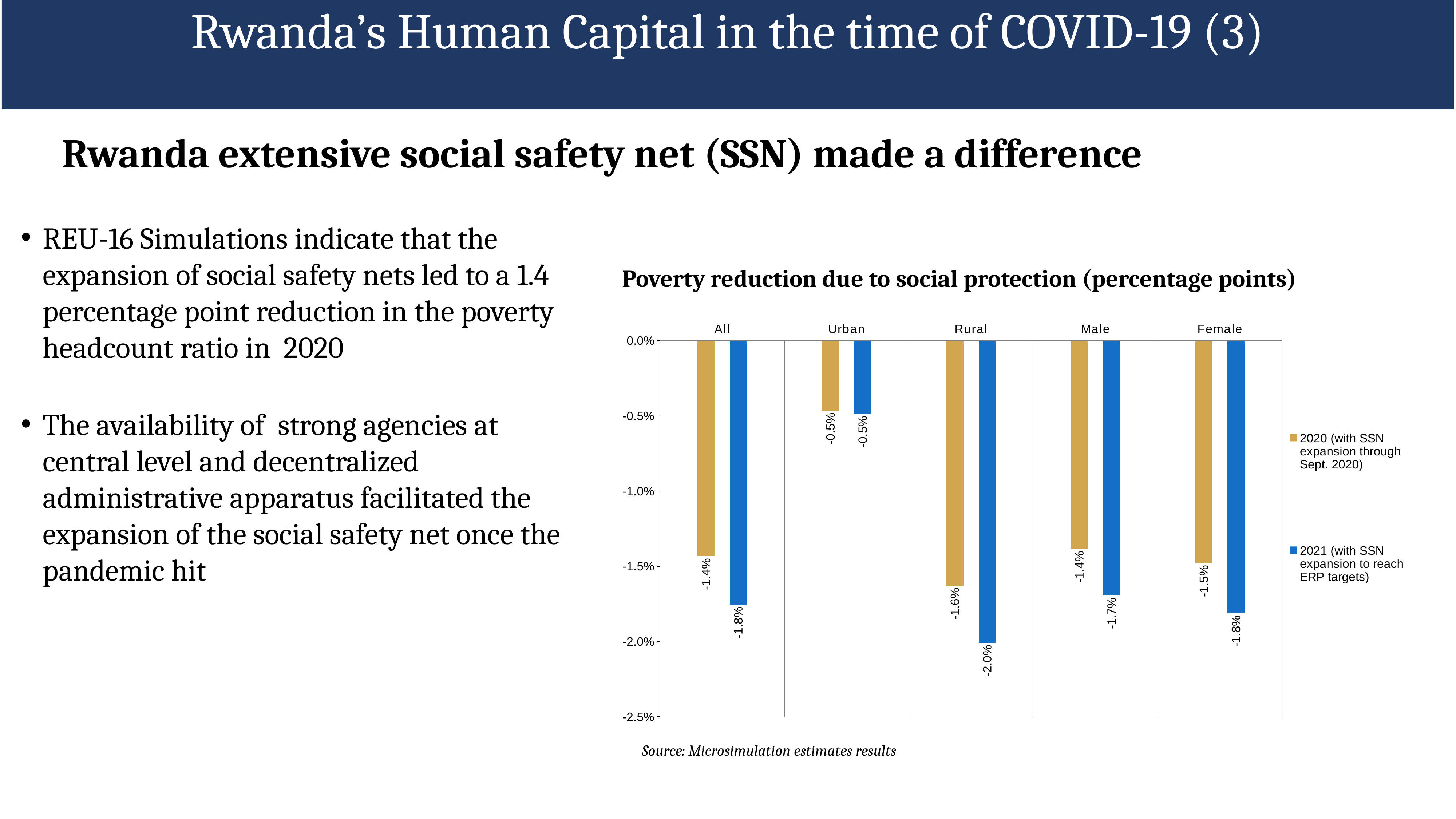
Which shows a larger poverty reduction for Female: the 2020 series or the 2021 series? 2021 (with SSN expansion to reach ERP targets) Which category has the smallest poverty reduction (value closest to zero) in the 2020 (with SSN expansion through Sept. 2020) series? Urban Which category has the largest poverty reduction (most negative value) in the 2021 (with SSN expansion to reach ERP targets) series? Rural What is the 2021 (with SSN expansion to reach ERP targets) value for Female? -1.8% What is the 2021 (with SSN expansion to reach ERP targets) value for All? -1.8% What type of chart is shown on the slide? Bar chart What is the 2020 (with SSN expansion through Sept. 2020) value for Urban? -0.5% How many categories are shown on the x axis of the chart? 5 What is the 2020 (with SSN expansion through Sept. 2020) value for Rural? -1.6% What is the difference between the 2021 and 2020 values for Male? 0.3 percentage points How many series does the chart legend list? 2 What is the difference between the 2021 and 2020 values for Rural? 0.4 percentage points